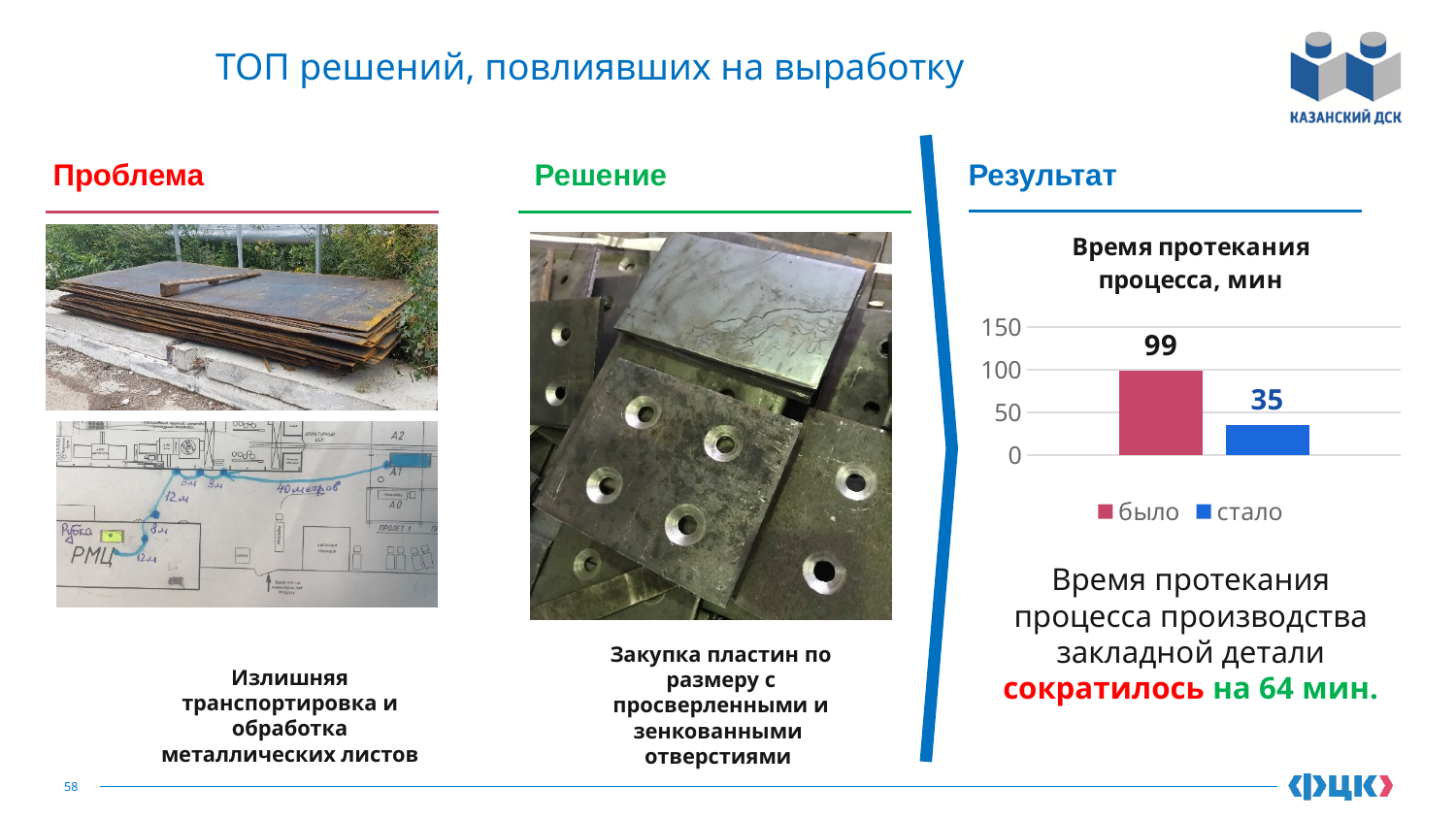
What kind of chart is shown on the slide? bar chart What is the value for "стало" in the chart "Время протекания процесса, мин"? 35 What is the value for "было" in the chart "Время протекания процесса, мин"? 99 How many series does the chart legend list? 2 What is the title of the chart on the slide? Время протекания процесса, мин Which series has the higher value in the chart, "было" or "стало"? было What colour is the bar for "стало" in the chart? blue What is the difference between the "было" and "стало" values in the chart? 64 Which series has the lowest value in the chart "Время протекания процесса, мин"? стало Is the value for "было" greater or less than 50? greater What is the highest value shown on the chart's vertical axis? 150 Is the value for "стало" greater or less than 50? less